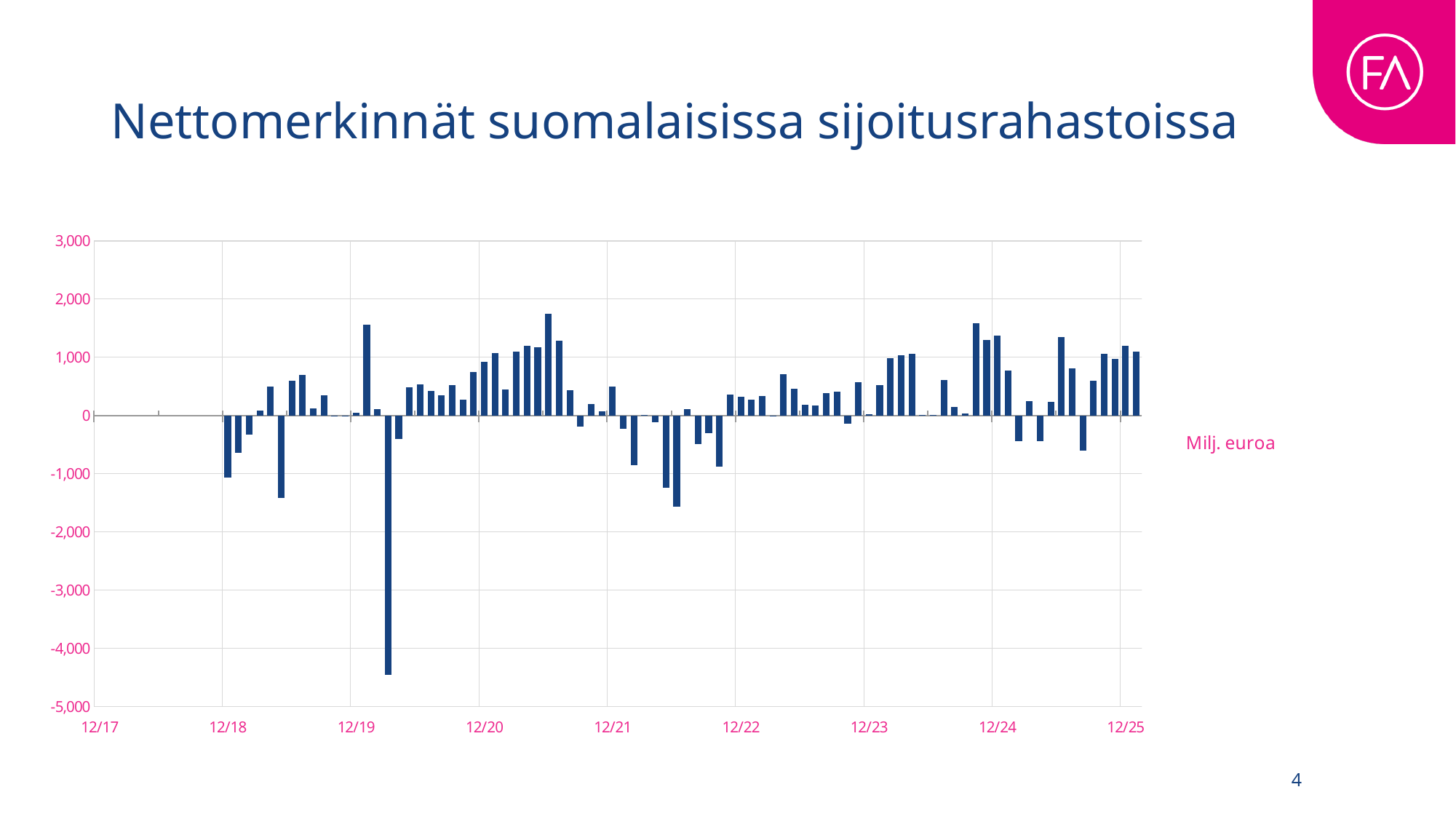
What is the title of the chart? Nettomerkinnät suomalaisissa sijoitusrahastoissa Is the lowest value on the chart greater or less than -4,000? less Is the highest value on the chart greater or less than 1,000? greater What unit is indicated next to the chart? Milj. euroa What kind of chart is shown on the slide? bar chart What is the highest value shown on the y axis? 3,000 Which is larger, the value for 12/24 or the value for 12/18? 12/24 Is the value for 12/18 greater or less than 0? less How many date labels are shown on the x axis? 9